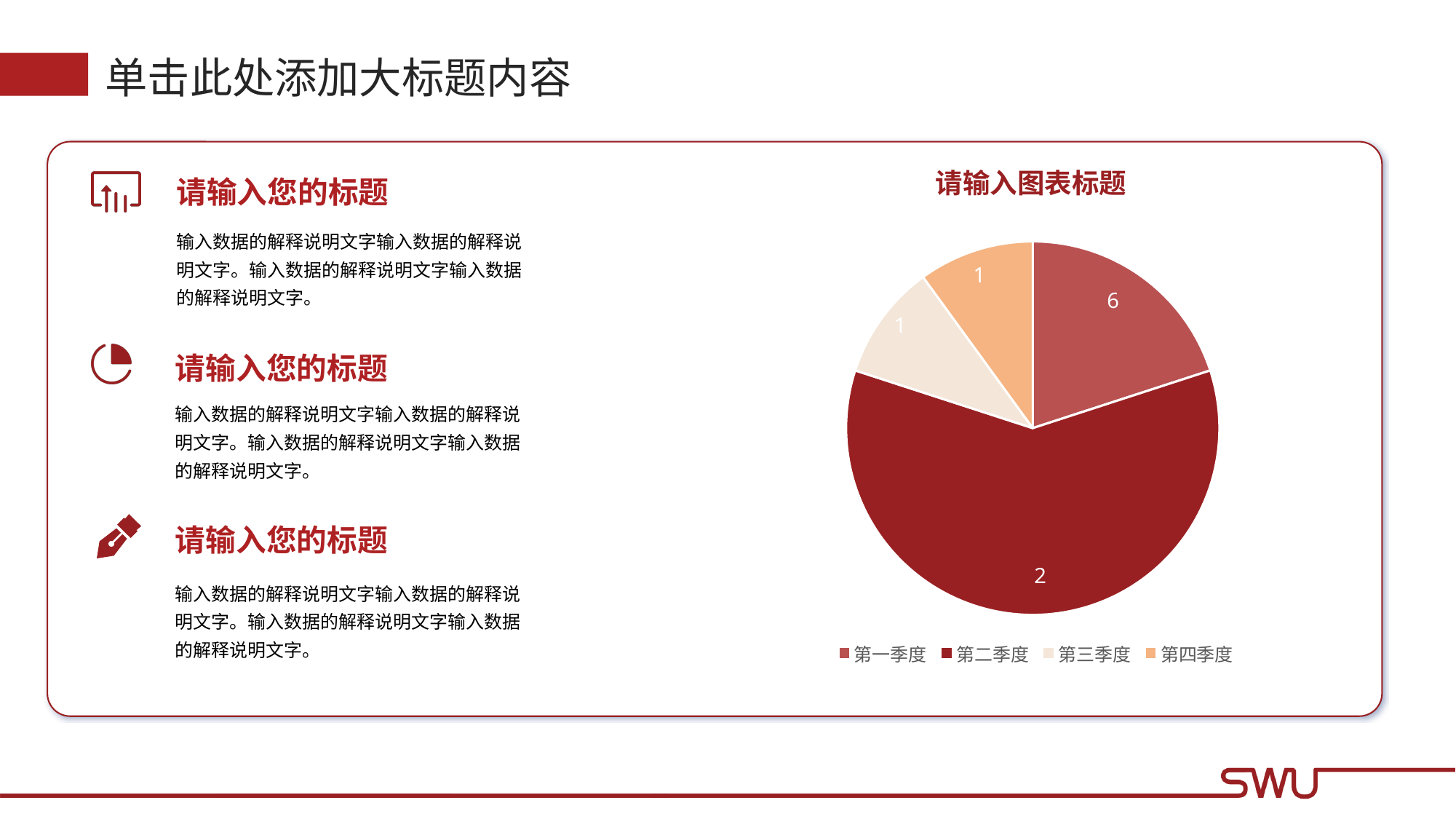
What data label is printed on the 第二季度 slice? 2 What data label is printed on the 第一季度 slice? 6 Which slice takes up the largest area of the pie? 第二季度 How many entries does the chart legend list? 4 What data label is printed on the 第三季度 slice? 1 What data label is printed on the 第四季度 slice? 1 Which legend entry is shown in the darkest red colour? 第二季度 How many slices does the pie chart have? 4 What kind of chart is shown on the slide? pie chart What is the title of the chart? 请输入图表标题